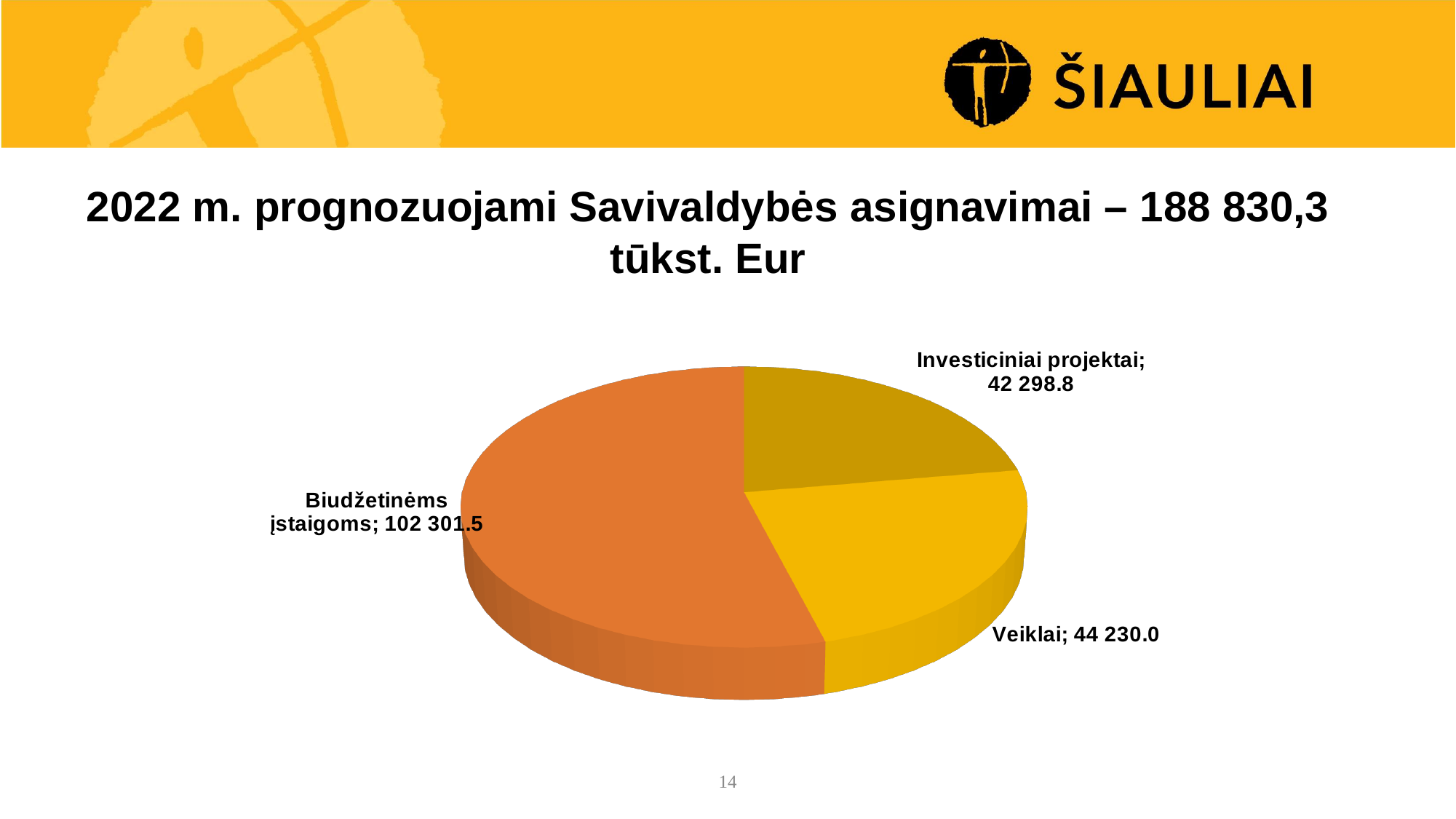
What type of chart is shown on the slide? pie chart Which is larger, Veiklai or Investiciniai projektai? Veiklai What is the value for Veiklai? 44 230.0 How many slices does the pie chart have? 3 What is the value for Investiciniai projektai? 42 298.8 What is the difference between Biudžetinėms įstaigoms and Veiklai? 58 071.5 What is the total of all three slices of the pie? 188 830.3 Which category has the smallest slice of the pie? Investiciniai projektai What total amount of Savivaldybės asignavimai for 2022 is stated in the slide title? 188 830,3 tūkst. Eur What is the difference between Veiklai and Investiciniai projektai? 1 931.2 Which category has the largest slice of the pie? Biudžetinėms įstaigoms What is the value for Biudžetinėms įstaigoms? 102 301.5